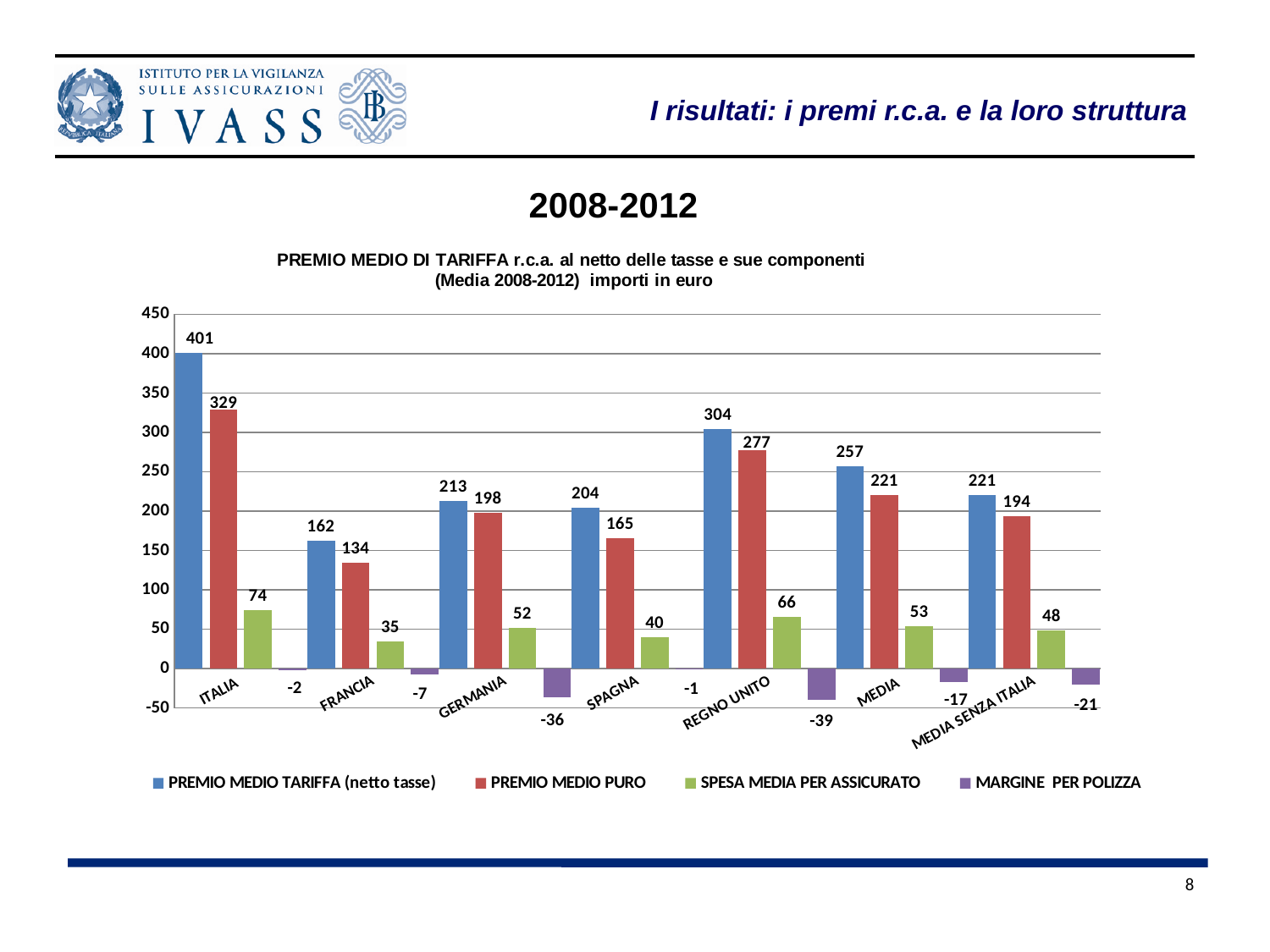
What is the difference between the PREMIO MEDIO TARIFFA (netto tasse) and PREMIO MEDIO PURO values for ITALIA? 72 Which category has the highest PREMIO MEDIO TARIFFA (netto tasse) value? ITALIA What is the MARGINE PER POLIZZA value for SPAGNA? -1 How many categories are shown on the x axis? 7 What is the PREMIO MEDIO PURO value for REGNO UNITO? 277 Which series is shown in green in the legend? SPESA MEDIA PER ASSICURATO Which category has the lowest PREMIO MEDIO PURO value? FRANCIA Which is larger: the SPESA MEDIA PER ASSICURATO value for ITALIA or for REGNO UNITO? ITALIA How many series does the legend list? 4 What is the PREMIO MEDIO TARIFFA (netto tasse) value for ITALIA? 401 What is the SPESA MEDIA PER ASSICURATO value for GERMANIA? 52 What kind of chart is shown on the slide? Bar chart